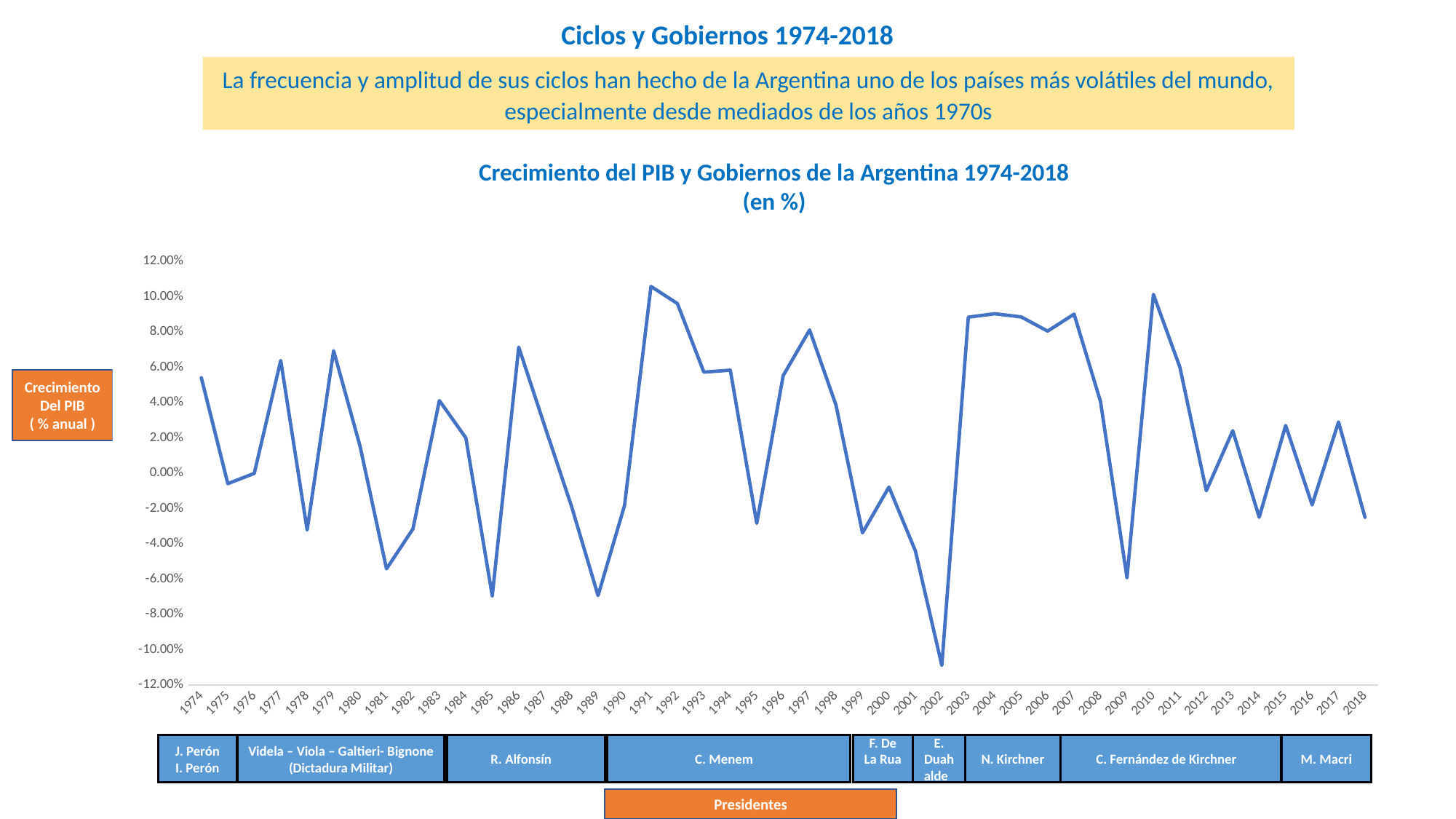
Which is larger, the value for 1983 or the value for 1985? 1983 Is the value for 1989 greater or less than -6.00%? less According to the presidents bar below the chart, which president corresponds to the years 1990 to 1998? C. Menem Do the values rise or fall from 1991 to 1995? fall What is the title of the chart? Crecimiento del PIB y Gobiernos de la Argentina 1974-2018 (en %) What kind of chart is shown on the slide? line chart Is the value for 1997 greater or less than 6.00%? greater Is the value for 1986 greater or less than 6.00%? greater Which year shows the lowest GDP growth value in the chart? 2002 How many years are plotted along the x axis of the chart? 45